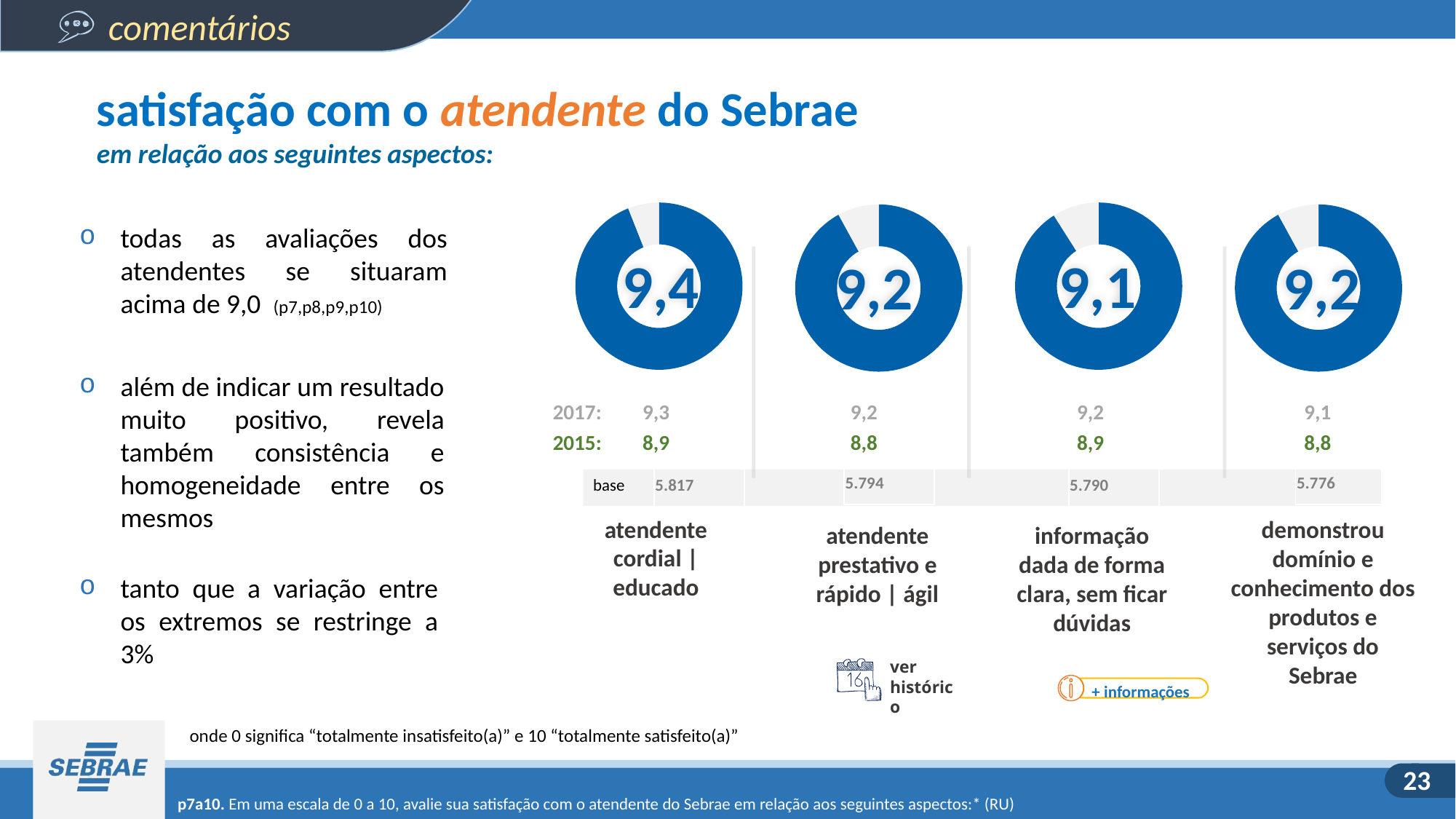
What is the satisfaction score shown in the donut chart for "demonstrou domínio e conhecimento dos produtos e serviços do Sebrae"? 9,2 Which aspect has the highest satisfaction score among the four donut charts? atendente cordial | educado Which has a higher score: "atendente cordial | educado" or "atendente prestativo e rápido | ágil"? atendente cordial | educado What is the satisfaction score shown in the donut chart for "atendente cordial | educado"? 9,4 What was the 2015 score shown below the donut chart for "demonstrou domínio e conhecimento dos produtos e serviços do Sebrae"? 8,8 What was the 2017 score shown below the donut chart for "atendente cordial | educado"? 9,3 What is the satisfaction score shown in the donut chart for "informação dada de forma clara, sem ficar dúvidas"? 9,1 What is the satisfaction score shown in the donut chart for "atendente prestativo e rápido | ágil"? 9,2 How many donut charts are shown on the slide? 4 Which aspect has the lowest satisfaction score among the four donut charts? informação dada de forma clara, sem ficar dúvidas What type of chart is used to display the satisfaction scores? Donut chart What is the difference between the score for "atendente cordial | educado" and the score for "informação dada de forma clara, sem ficar dúvidas"? 0,3